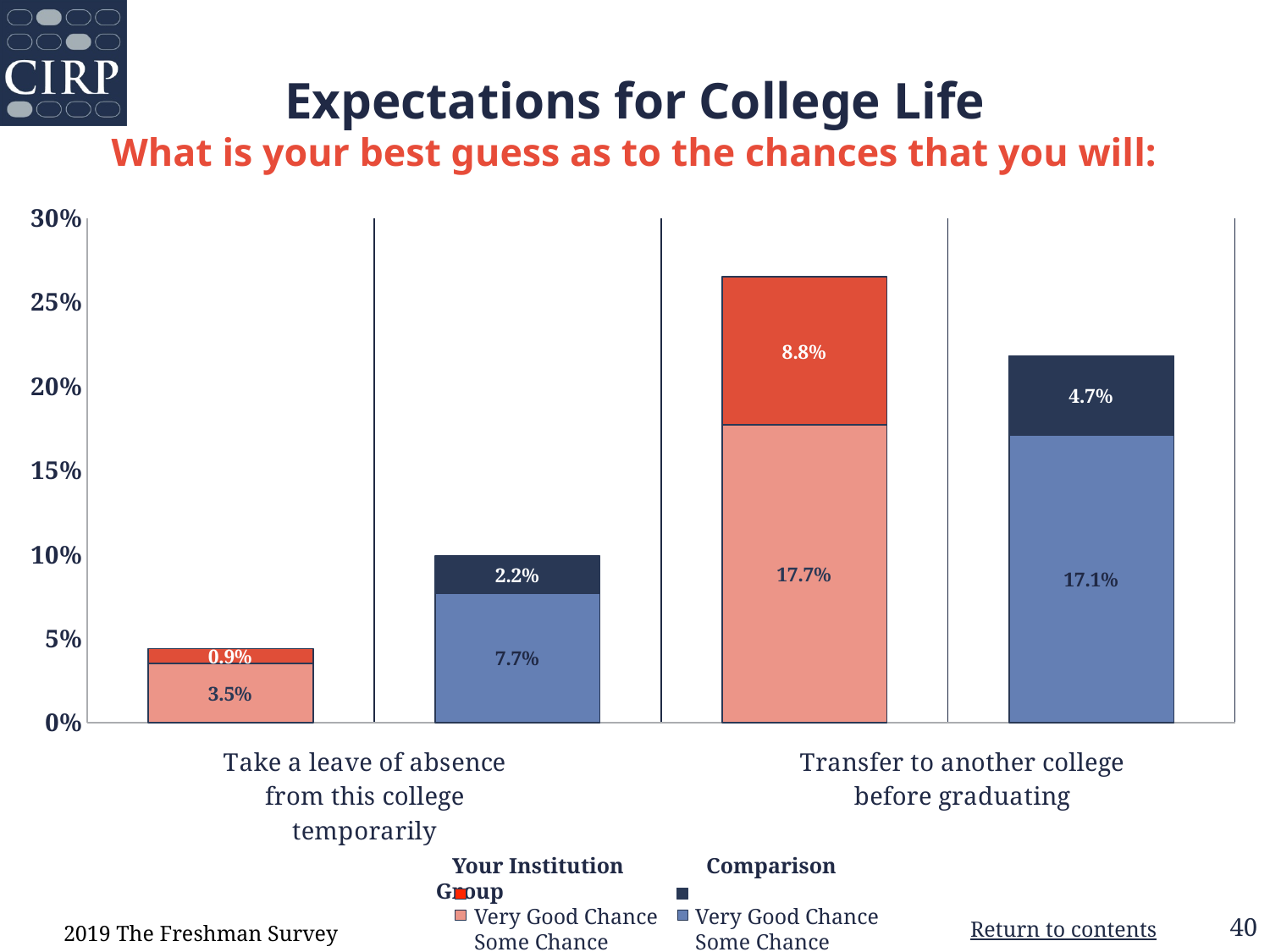
What is the 'Very Good Chance' value for the Comparison Group for 'Transfer to another college before graduating'? 4.7% What is the total of the Your Institution stacked bar for 'Transfer to another college before graduating'? 26.5% How many series does the legend list? 4 Which is larger for 'Take a leave of absence from this college temporarily': the 'Some Chance' value for Your Institution or for the Comparison Group? Comparison Group Which of the two questions has the highest 'Very Good Chance' value for Your Institution? Transfer to another college before graduating What is the difference between the 'Very Good Chance' values for Your Institution and the Comparison Group for 'Transfer to another college before graduating'? 4.1% What type of chart is shown on the slide? Stacked bar chart What is the total of the Comparison Group stacked bar for 'Take a leave of absence from this college temporarily'? 9.9% What is the 'Very Good Chance' value for Your Institution for 'Take a leave of absence from this college temporarily'? 0.9% What is the 'Some Chance' value for Your Institution for 'Take a leave of absence from this college temporarily'? 3.5% What is the 'Some Chance' value for the Comparison Group for 'Transfer to another college before graduating'? 17.1% How many question categories are shown on the x axis? 2